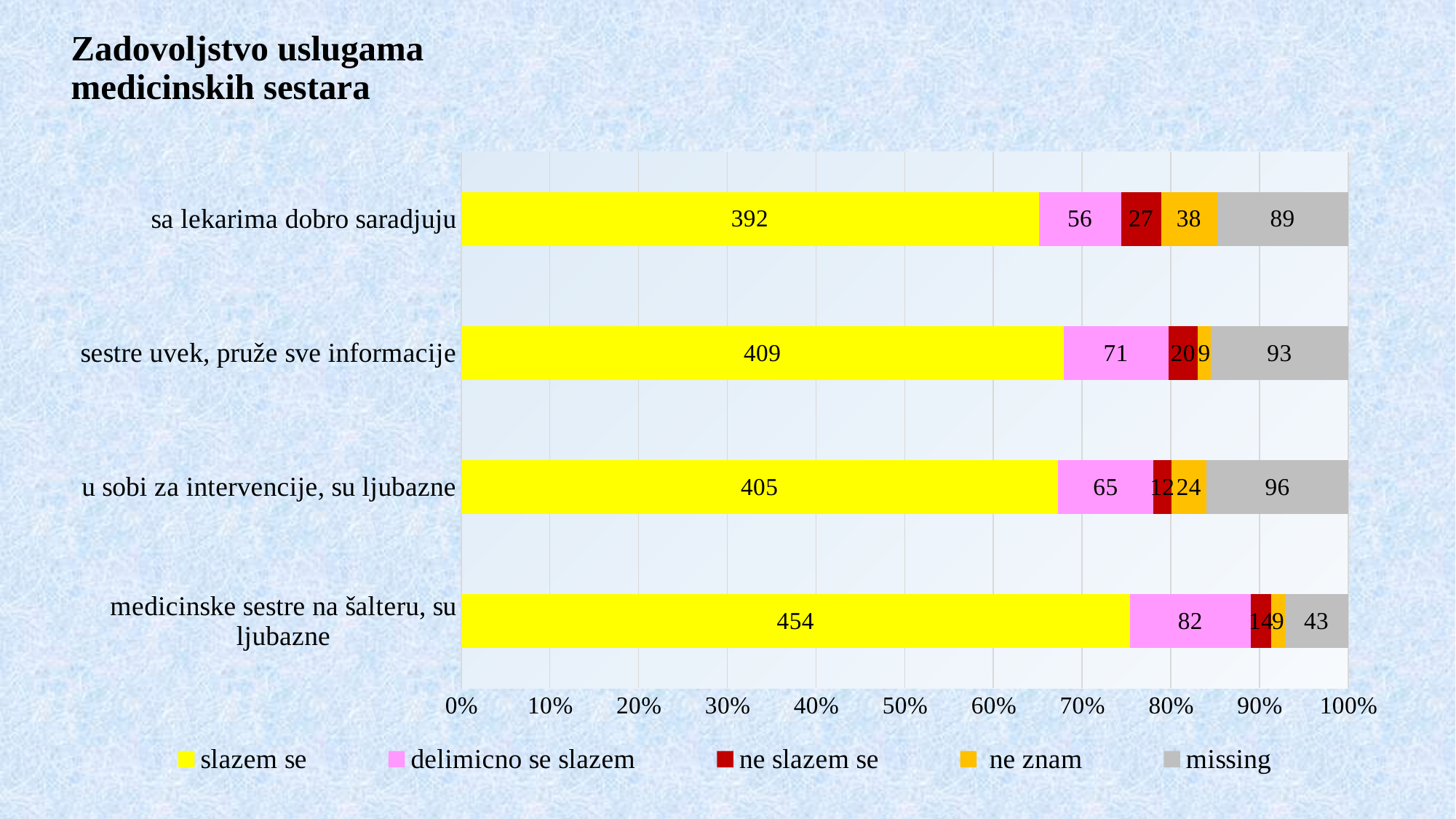
What is the value of "missing" for "u sobi za intervencije, su ljubazne"? 96 How many categories are shown on the chart? 4 How many series does the legend list? 5 What is the value of "slazem se" for "sa lekarima dobro saradjuju"? 392 Which category has the lowest "missing" value? medicinske sestre na šalteru, su ljubazne What is the difference in "slazem se" between "medicinske sestre na šalteru, su ljubazne" and "sa lekarima dobro saradjuju"? 62 What kind of chart is shown on the slide? Stacked bar chart What is the value of "delimicno se slazem" for "medicinske sestre na šalteru, su ljubazne"? 82 Which has a larger "missing" value: "sestre uvek, pruže sve informacije" or "sa lekarima dobro saradjuju"? sestre uvek, pruže sve informacije What is the difference in "delimicno se slazem" between "sestre uvek, pruže sve informacije" and "sa lekarima dobro saradjuju"? 15 Which category has the highest "slazem se" value? medicinske sestre na šalteru, su ljubazne What is the value of "ne slazem se" for "sa lekarima dobro saradjuju"? 27